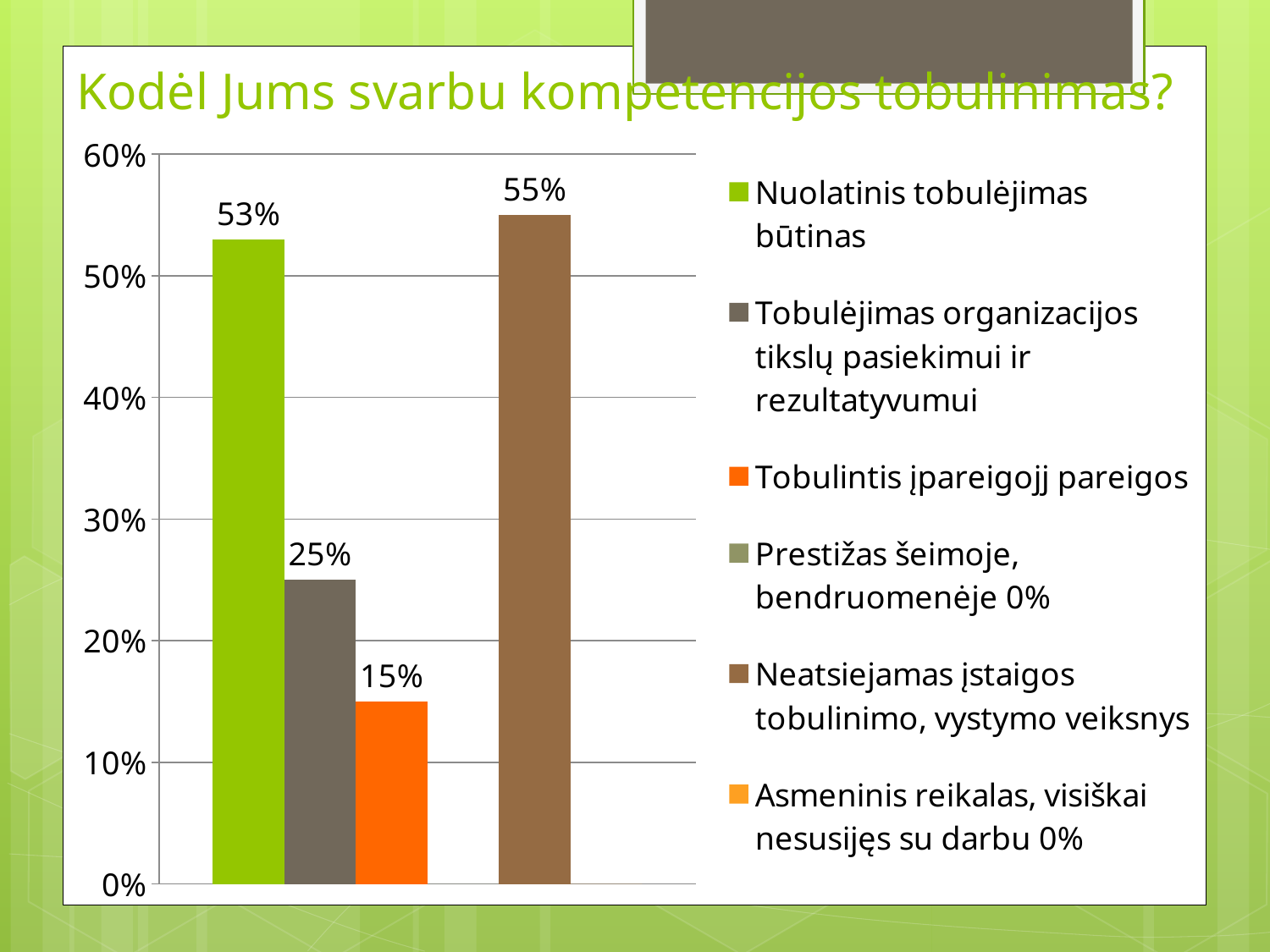
Which is larger: the value for "Nuolatinis tobulėjimas būtinas" or the value for "Tobulėjimas organizacijos tikslų pasiekimui ir rezultatyvumui"? Nuolatinis tobulėjimas būtinas What value is shown for "Nuolatinis tobulėjimas būtinas"? 53% Which legend entry has the highest value? Neatsiejamas įstaigos tobulinimo, vystymo veiksnys What is the difference between the values for "Neatsiejamas įstaigos tobulinimo, vystymo veiksnys" and "Nuolatinis tobulėjimas būtinas"? 2% What is the difference between the values for "Tobulėjimas organizacijos tikslų pasiekimui ir rezultatyvumui" and "Tobulintis įpareigoji pareigos"? 10% What value is shown for "Neatsiejamas įstaigos tobulinimo, vystymo veiksnys"? 55% What value does the legend give for "Prestižas šeimoje, bendruomenėje"? 0% Is the value for "Tobulintis įpareigoji pareigos" greater or less than 20%? less What kind of chart is shown on the slide? bar chart What value is shown for "Tobulėjimas organizacijos tikslų pasiekimui ir rezultatyvumui"? 25% How many entries does the legend list? 6 What value is shown for "Tobulintis įpareigoji pareigos"? 15%